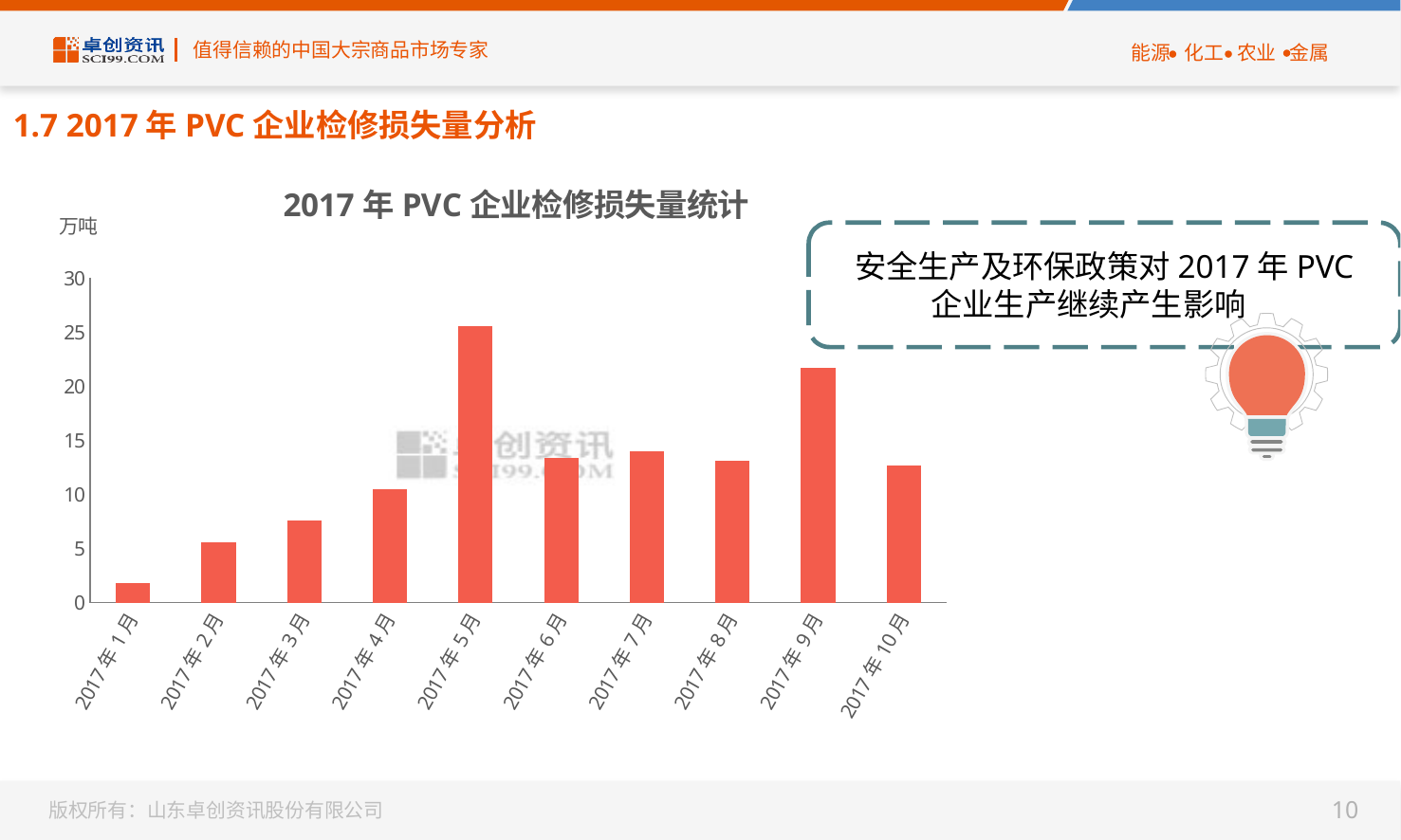
What unit is shown on the y axis of the chart? 万吨 Which month has the lowest PVC maintenance loss volume? 2017年1月 Do the values rise or fall from 2017年1月 to 2017年5月? rise Which is larger, the value for 2017年4月 or 2017年2月? 2017年4月 Is the value for 2017年1月 greater or less than 5? less Which is larger, the value for 2017年5月 or 2017年9月? 2017年5月 Is the value for 2017年9月 greater or less than 20? greater Is the value for 2017年3月 greater or less than 10? less What kind of chart is shown on the slide? bar chart How many months are plotted on the x axis of the chart? 10 Which month has the highest PVC maintenance loss volume? 2017年5月